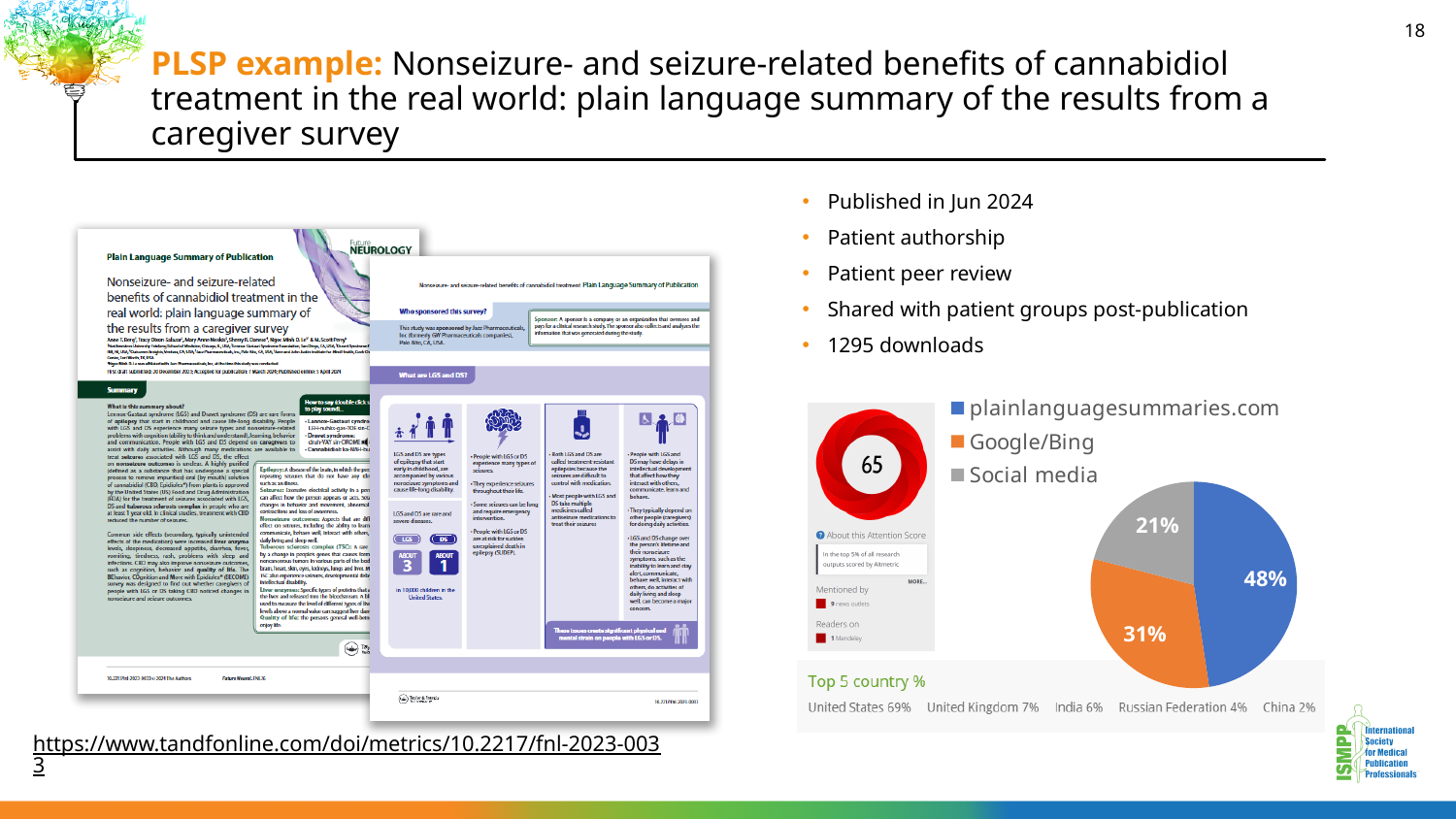
What share of the pie chart does Social media account for? 21% What kind of chart is shown on the slide? pie chart How many slices does the pie chart have? 3 What share of the pie chart does Google/Bing account for? 31% Which source has the smallest slice in the pie chart? Social media Which source has the largest slice in the pie chart? plainlanguagesummaries.com What colour is the plainlanguagesummaries.com slice in the pie chart? blue How many entries does the pie chart legend list? 3 What share of the pie chart does plainlanguagesummaries.com account for? 48% What is the difference in percentage points between the plainlanguagesummaries.com slice and the Google/Bing slice? 17 Which is larger in the pie chart, Google/Bing or Social media? Google/Bing What is the difference in percentage points between the Google/Bing slice and the Social media slice? 10